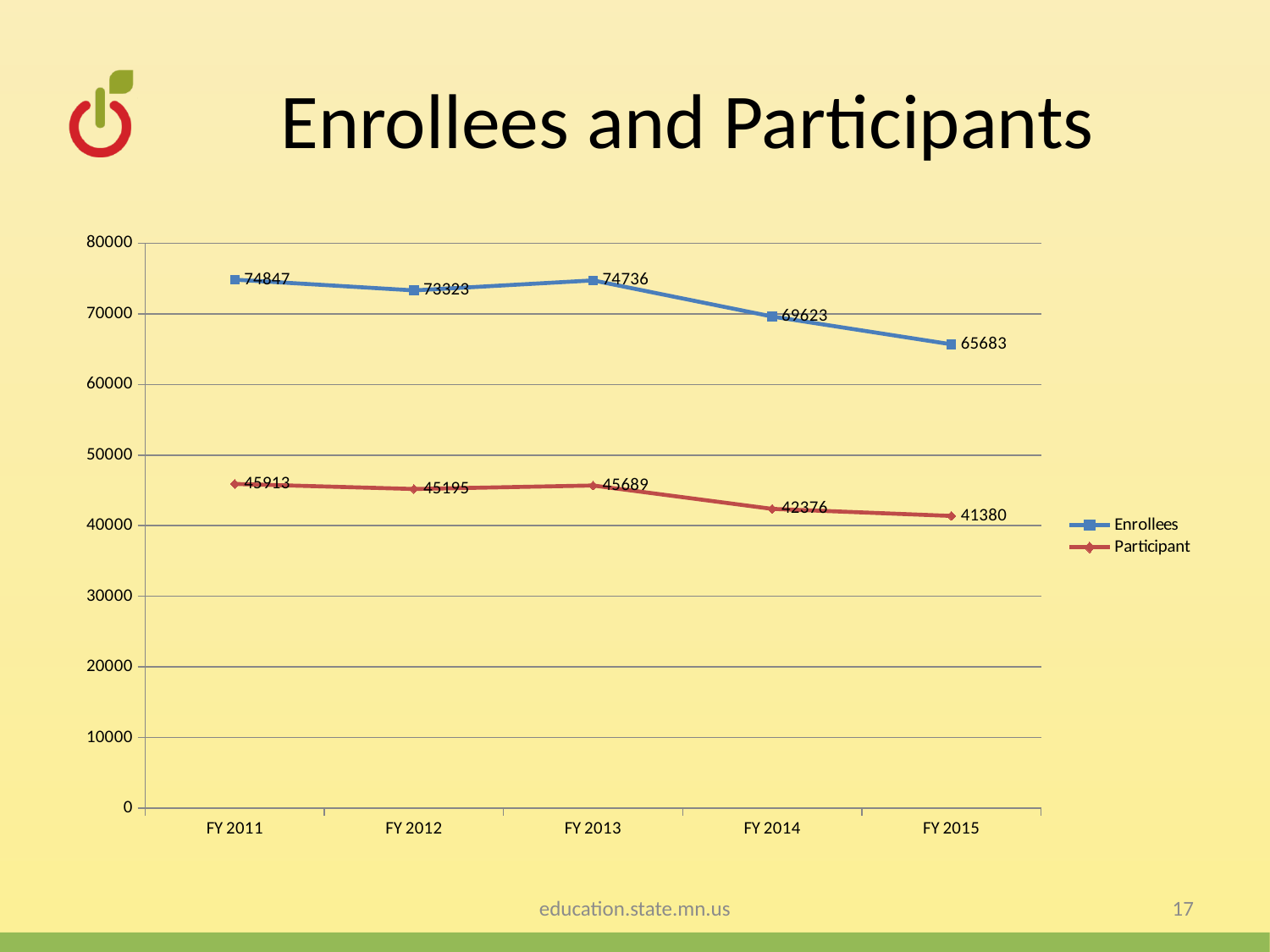
In which fiscal year is the Participant value highest? FY 2011 In which fiscal year is the Enrollees value lowest? FY 2015 How many fiscal years are shown on the x axis? 5 What kind of chart is shown on the slide? Line chart How many series does the legend list? 2 Do the Enrollees values generally rise or fall from FY 2013 to FY 2015? Fall What is the number of Enrollees in FY 2013? 74736 By how much did the number of Enrollees fall from FY 2011 to FY 2015? 9164 Which is larger, the Participant value in FY 2012 or in FY 2013? FY 2013 What is the number of Enrollees in FY 2011? 74847 What is the number of Participants in FY 2015? 41380 What is the difference between Enrollees and Participants in FY 2014? 27247